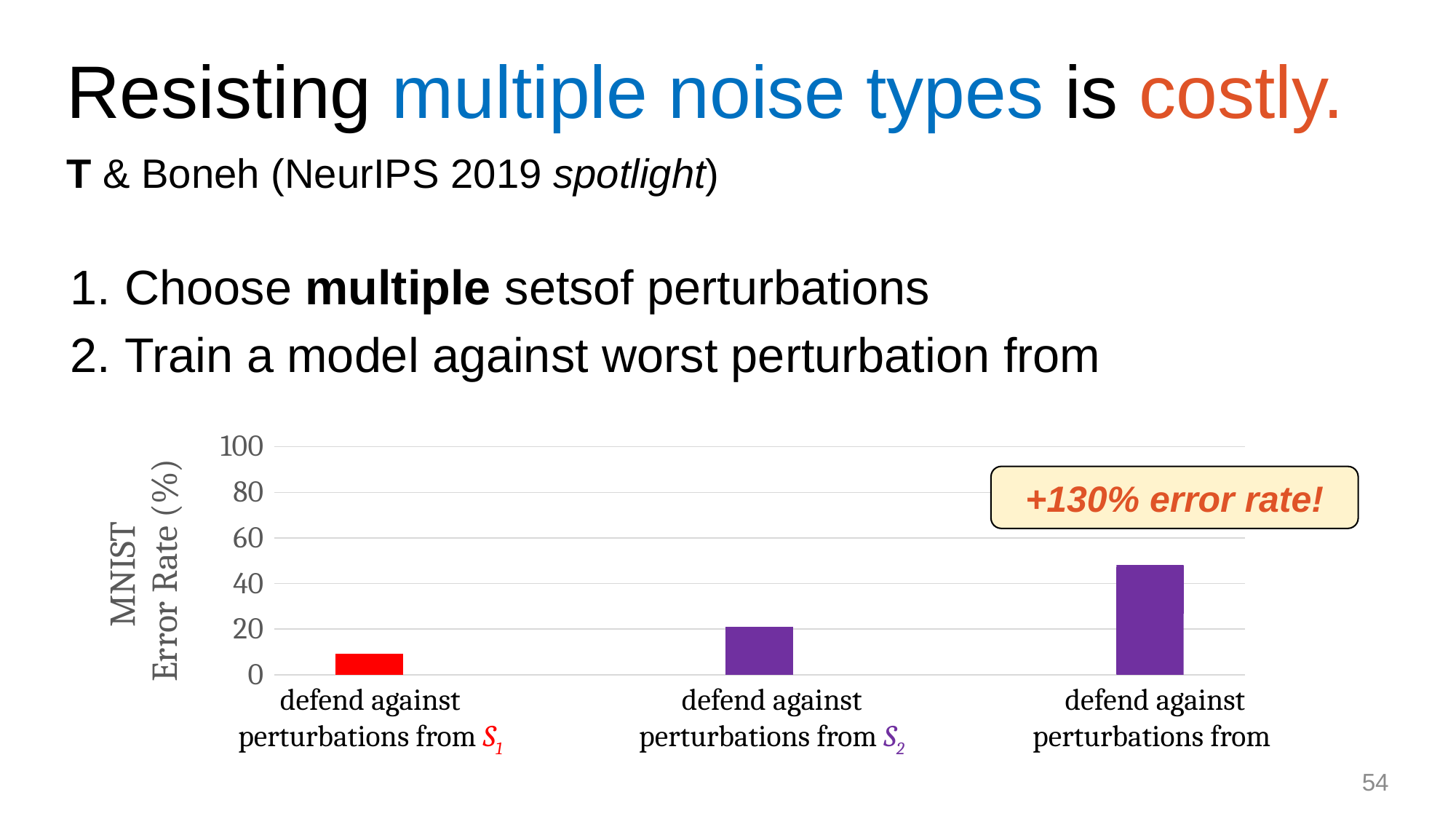
How many bars (categories) does the chart show? 3 Which category has the lowest MNIST error rate? defend against perturbations from S1 Which has a higher error rate: defending against perturbations from S1 or from S2? S2 Is the error rate for 'defend against perturbations from S2' greater or less than 40? less What does the callout box next to the chart say? +130% error rate! Is the error rate for 'defend against perturbations from S1' greater or less than 20? less What kind of chart is shown on the slide? bar chart Which category has the highest MNIST error rate? the rightmost bar (labeled 'defend against perturbations from', set name not shown) Is the error rate for the rightmost bar greater or less than 60? less Do the bar values rise or fall from left to right across the chart? rise What is the label on the vertical axis of the chart? MNIST Error Rate (%)